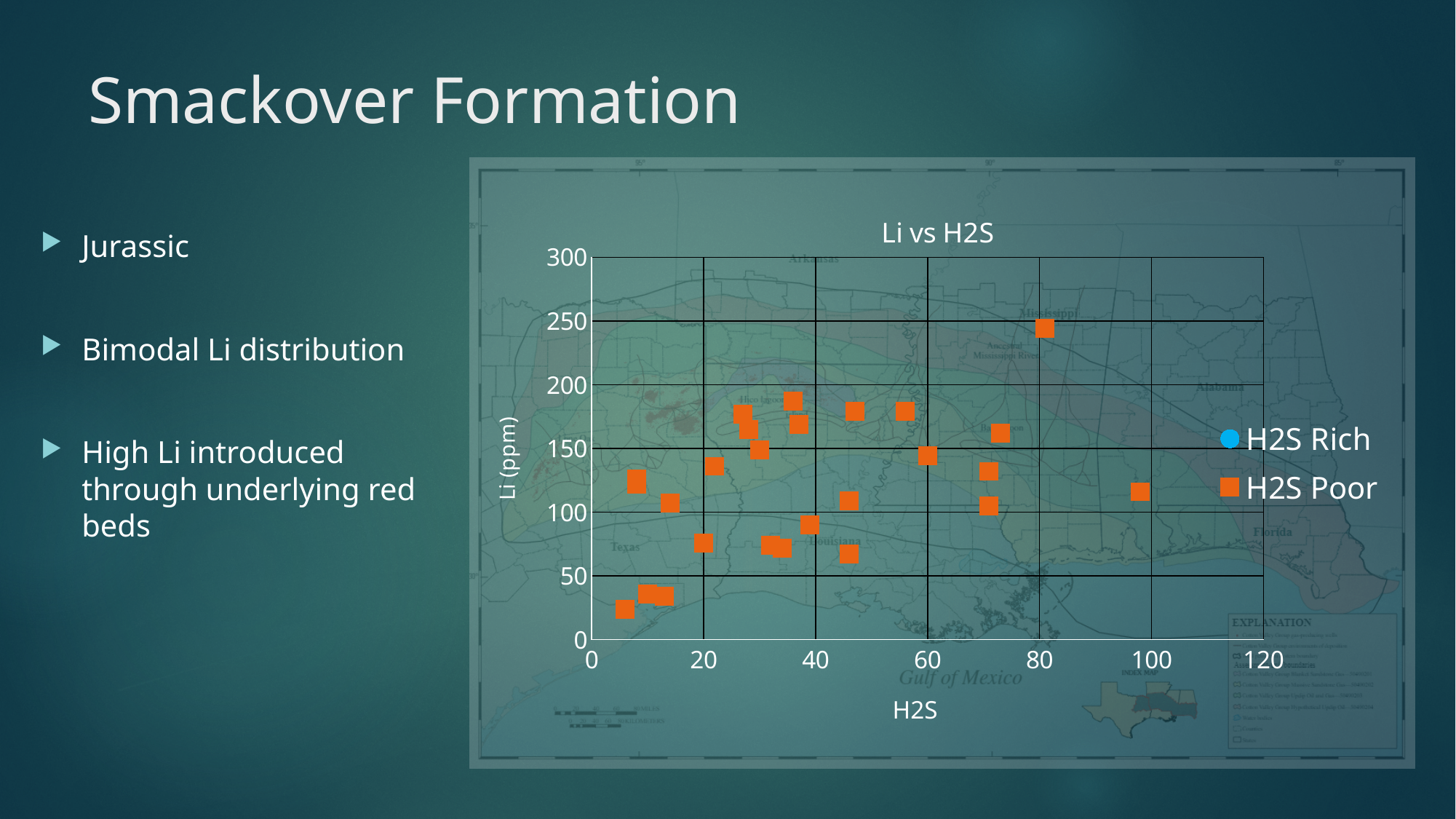
Is the highest Li (ppm) value plotted on the chart greater or less than 200? greater What kind of chart is shown on the slide? scatter chart Is the H2S value of the point with the highest Li (ppm) greater or less than 60? greater What is the title of the chart on the slide? Li vs H2S Which series in the legend is shown with orange square markers? H2S Poor Is the Li (ppm) value of the rightmost plotted point greater or less than 150? less How many series does the chart's legend list? 2